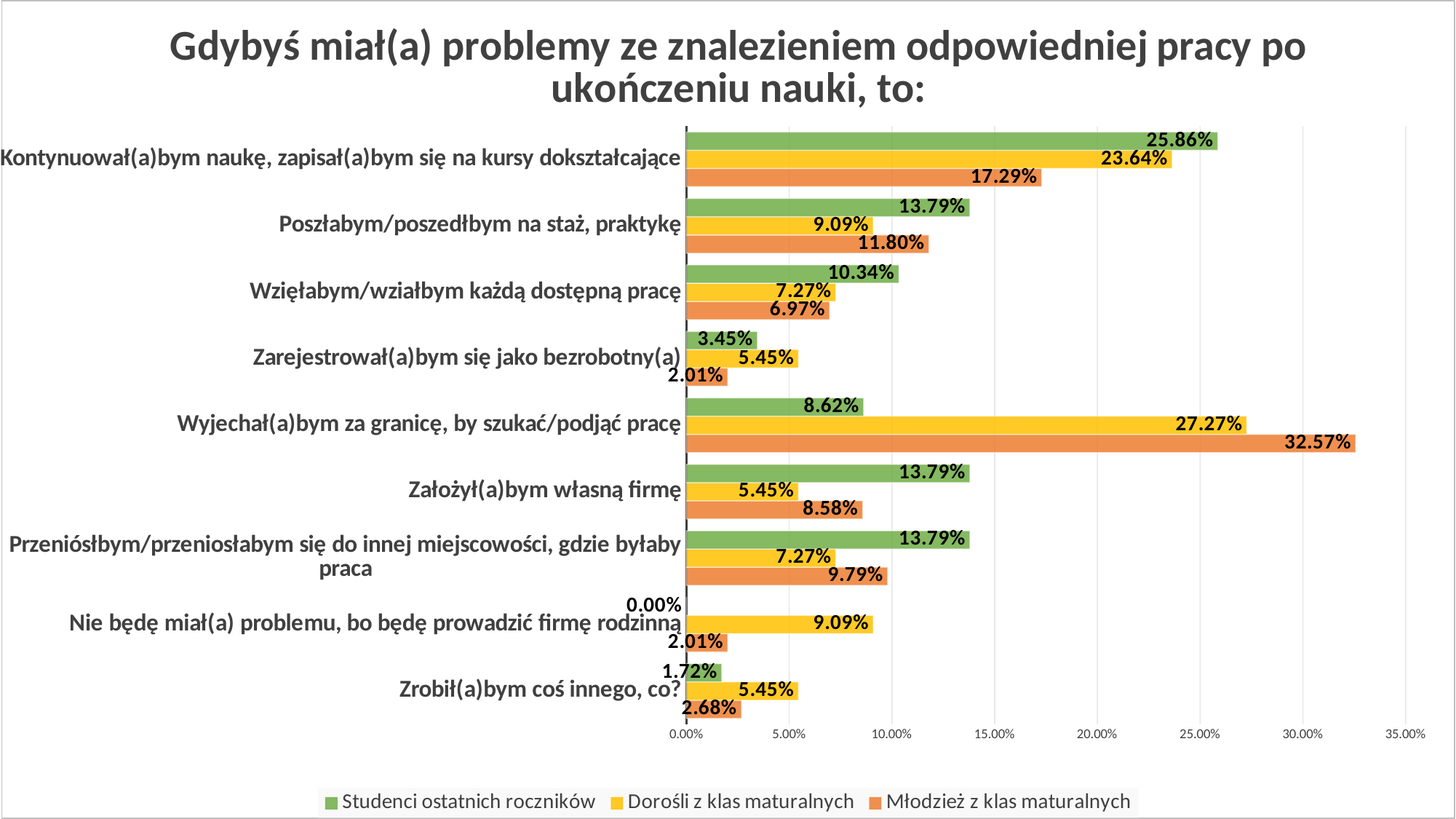
What is the value for 'Studenci ostatnich roczników' in the category 'Kontynuował(a)bym naukę, zapisał(a)bym się na kursy dokształcające'? 25.86% What is the value for 'Młodzież z klas maturalnych' in the category 'Wyjechał(a)bym za granicę, by szukać/podjąć pracę'? 32.57% What is the difference between the 'Studenci ostatnich roczników' and 'Młodzież z klas maturalnych' values for 'Kontynuował(a)bym naukę, zapisał(a)bym się na kursy dokształcające'? 8.57% What type of chart is shown on the slide? bar chart Which colour represents the series 'Młodzież z klas maturalnych'? orange Is the value for 'Dorośli z klas maturalnych' in 'Wyjechał(a)bym za granicę, by szukać/podjąć pracę' greater or less than 25.00%? greater What is the value for 'Dorośli z klas maturalnych' in the category 'Nie będę miał(a) problemu, bo będę prowadzić firmę rodzinną'? 9.09% Which category has the lowest value for 'Studenci ostatnich roczników'? Nie będę miał(a) problemu, bo będę prowadzić firmę rodzinną For 'Założył(a)bym własną firmę', which series has the larger value: 'Studenci ostatnich roczników' or 'Młodzież z klas maturalnych'? Studenci ostatnich roczników How many series does the legend list? 3 Which category has the highest value for 'Dorośli z klas maturalnych'? Wyjechał(a)bym za granicę, by szukać/podjąć pracę How many categories are shown on the chart? 9